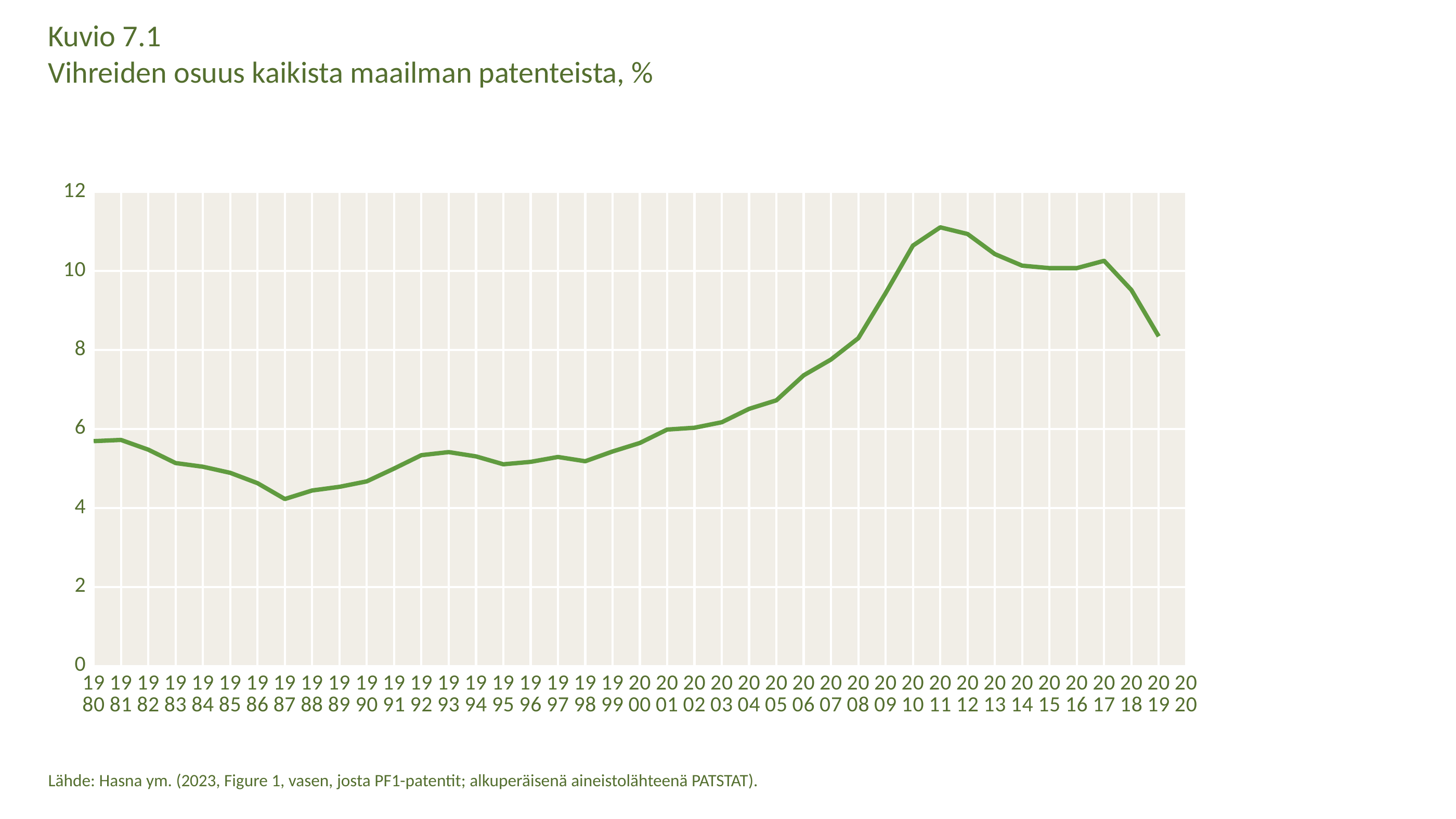
What kind of chart is shown on the slide? line chart Which year has the lowest value on the chart? 1987 Is the value for 2011 greater or less than 10? greater How many years are plotted along the x axis? 41 Is the value for 2000 greater or less than 6? less Is the value for 2008 greater or less than 8? greater Does the line rise or fall between 1987 and 2011? rise What is the title of the chart? Vihreiden osuus kaikista maailman patenteista, %